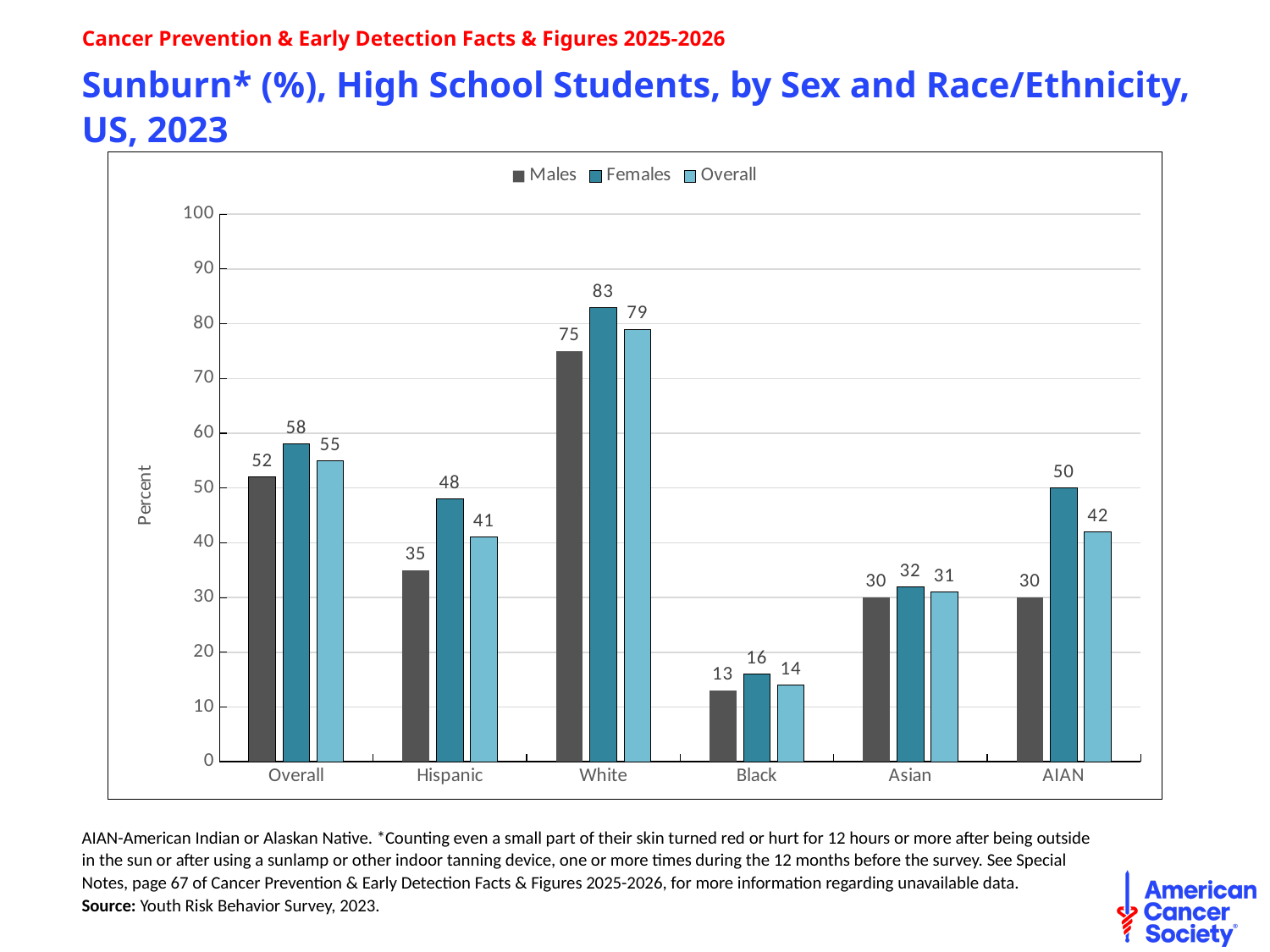
What kind of chart is shown on the slide? Bar chart What is the label on the y axis? Percent How many race/ethnicity categories are shown on the x axis? 6 What is the difference between the Females and Males sunburn percentages in the Black category? 3 How many series does the legend list? 3 Which race/ethnicity category has the lowest Males sunburn percentage? Black What is the Overall sunburn percentage for the AIAN category? 42 What is the difference between the Females and Males sunburn percentages in the AIAN category? 20 What is the sunburn percentage for Males in the Hispanic category? 35 What is the sunburn percentage for Females in the White category? 83 Which race/ethnicity category has the highest Overall sunburn percentage? White Which is larger, the Females value for Hispanic or the Females value for AIAN? Females value for AIAN